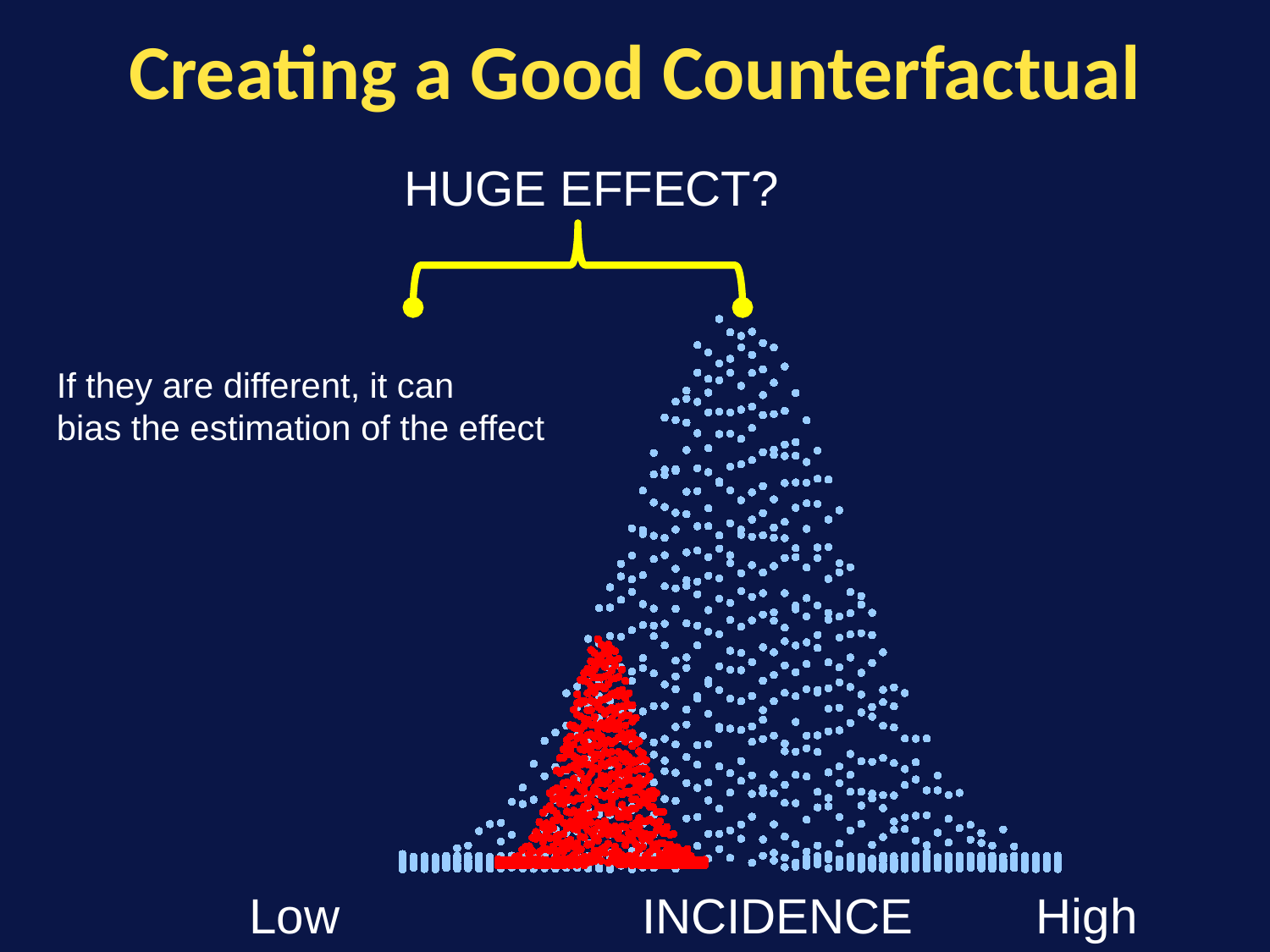
What is the label of the horizontal axis of the chart? INCIDENCE Which distribution is spread over a wider range of incidence, the red one or the light blue one? The light blue one How many dot distributions are plotted on the chart? 2 What labels mark the left and right ends of the horizontal axis? Low and High What kind of chart is shown on the slide? Dot plot (two dot distributions) Which distribution is centred at a lower incidence, the red one or the light blue one? The red one Which distribution has the taller peak, the red one or the light blue one? The light blue one